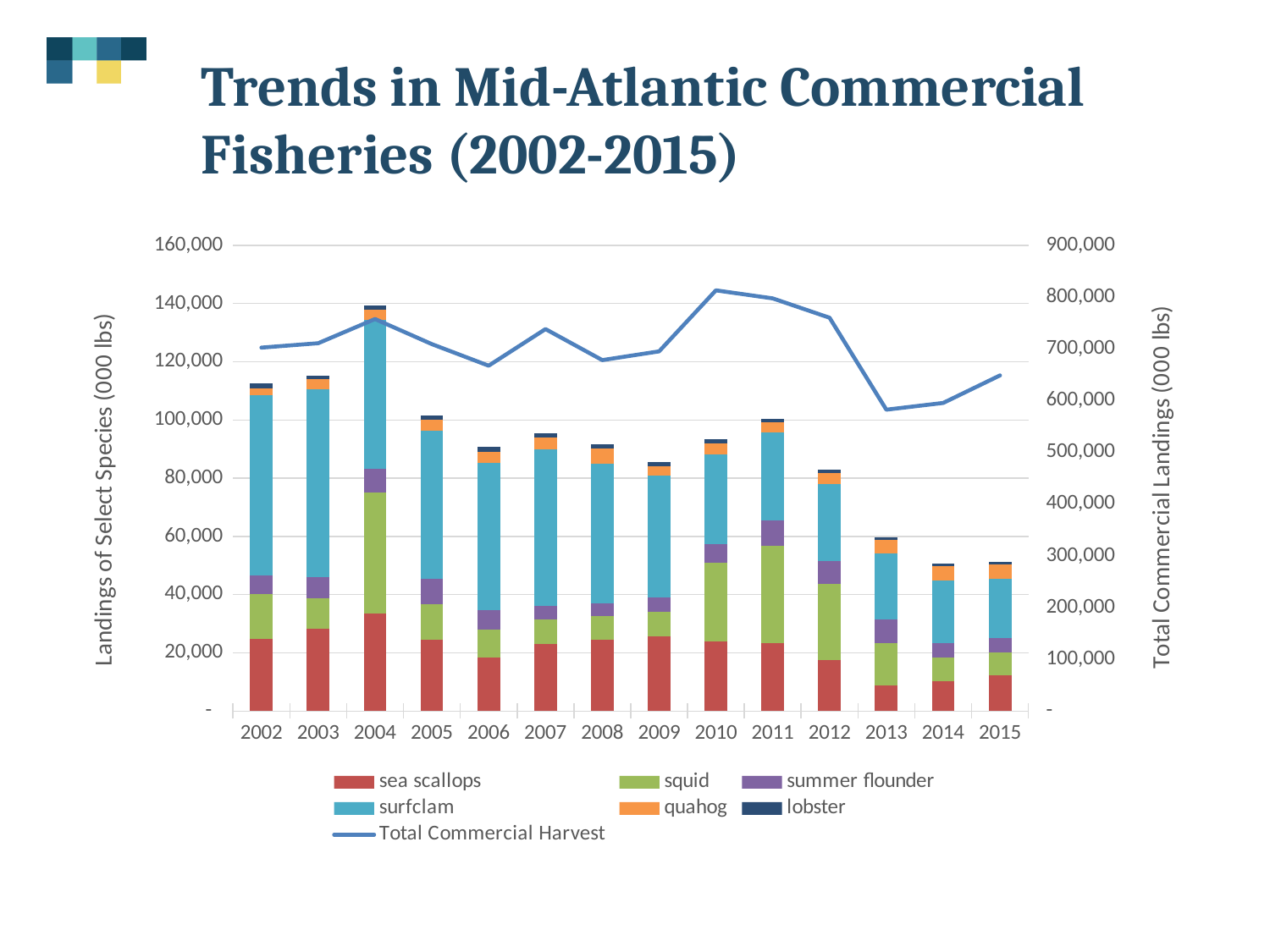
Is the Total Commercial Harvest value for 2002 greater or less than 600,000? greater Does the Total Commercial Harvest line rise or fall from 2012 to 2013? fall How many series does the legend list? 7 In which year does the Total Commercial Harvest line reach its highest point? 2010 What is the title of the right-hand vertical axis? Total Commercial Landings (000 lbs) How many years are shown along the x axis? 14 Is the total stacked bar for 2004 greater or less than 120,000? greater Which year has the tallest stacked bar for landings of select species? 2004 Which year has the taller stacked bar, 2011 or 2012? 2011 What kind of chart is shown on the slide? A stacked bar chart with a line Is the total stacked bar for 2014 greater or less than 60,000? less